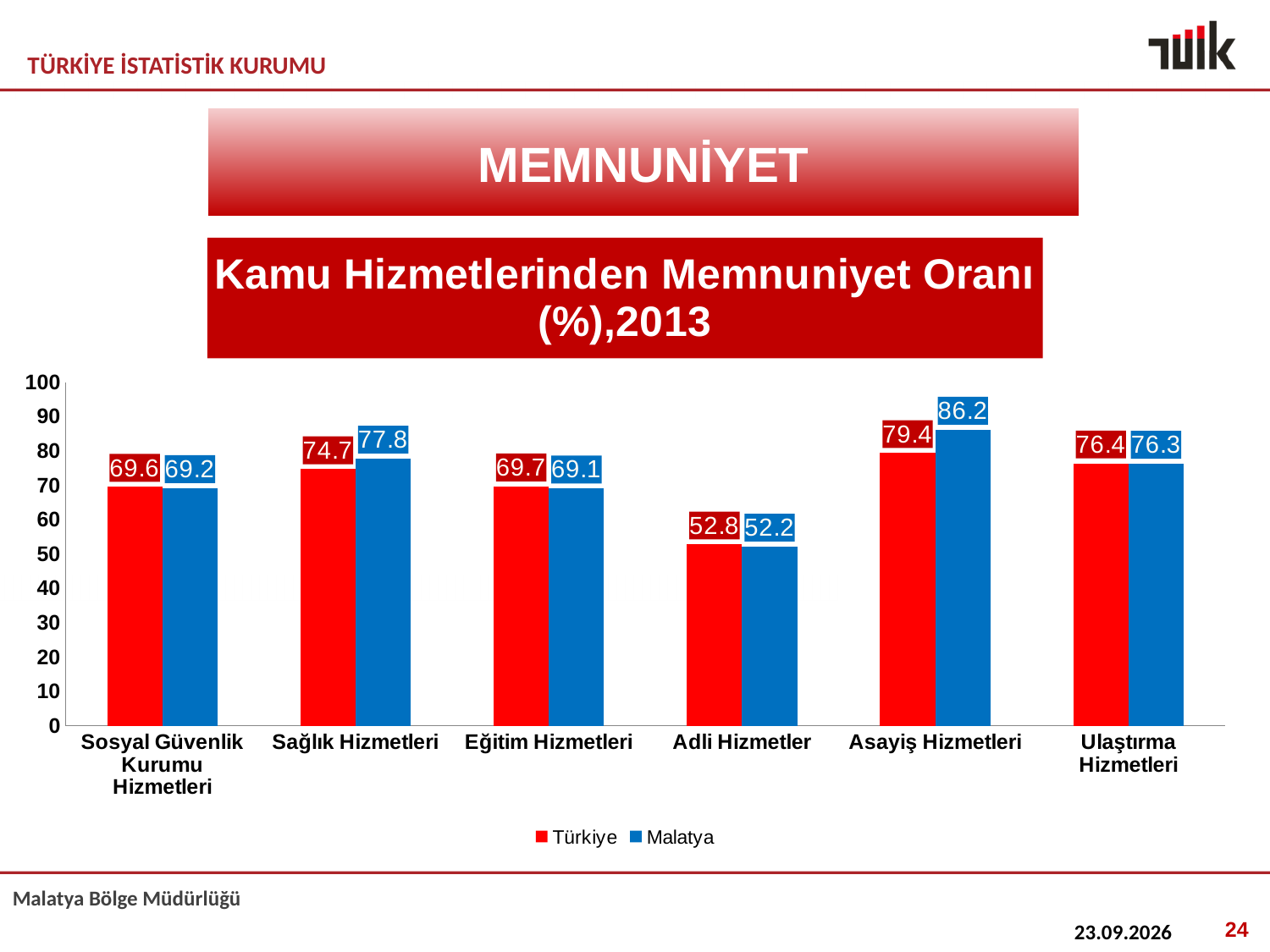
Is the Malatya value for Adli Hizmetler greater or less than 60? less What is the Türkiye value for Adli Hizmetler? 52.8 What is the Türkiye value for Sağlık Hizmetleri? 74.7 What kind of chart is shown on the slide? bar chart Which category has the highest Malatya value? Asayiş Hizmetleri Which category has the lowest Türkiye value? Adli Hizmetler Which colour represents Malatya in the chart? blue How many categories are shown on the x axis? 6 For Sağlık Hizmetleri, which is larger: the Türkiye value or the Malatya value? Malatya What is the difference between the Malatya and Türkiye values for Asayiş Hizmetleri? 6.8 How many series does the legend list? 2 What is the Malatya value for Asayiş Hizmetleri? 86.2